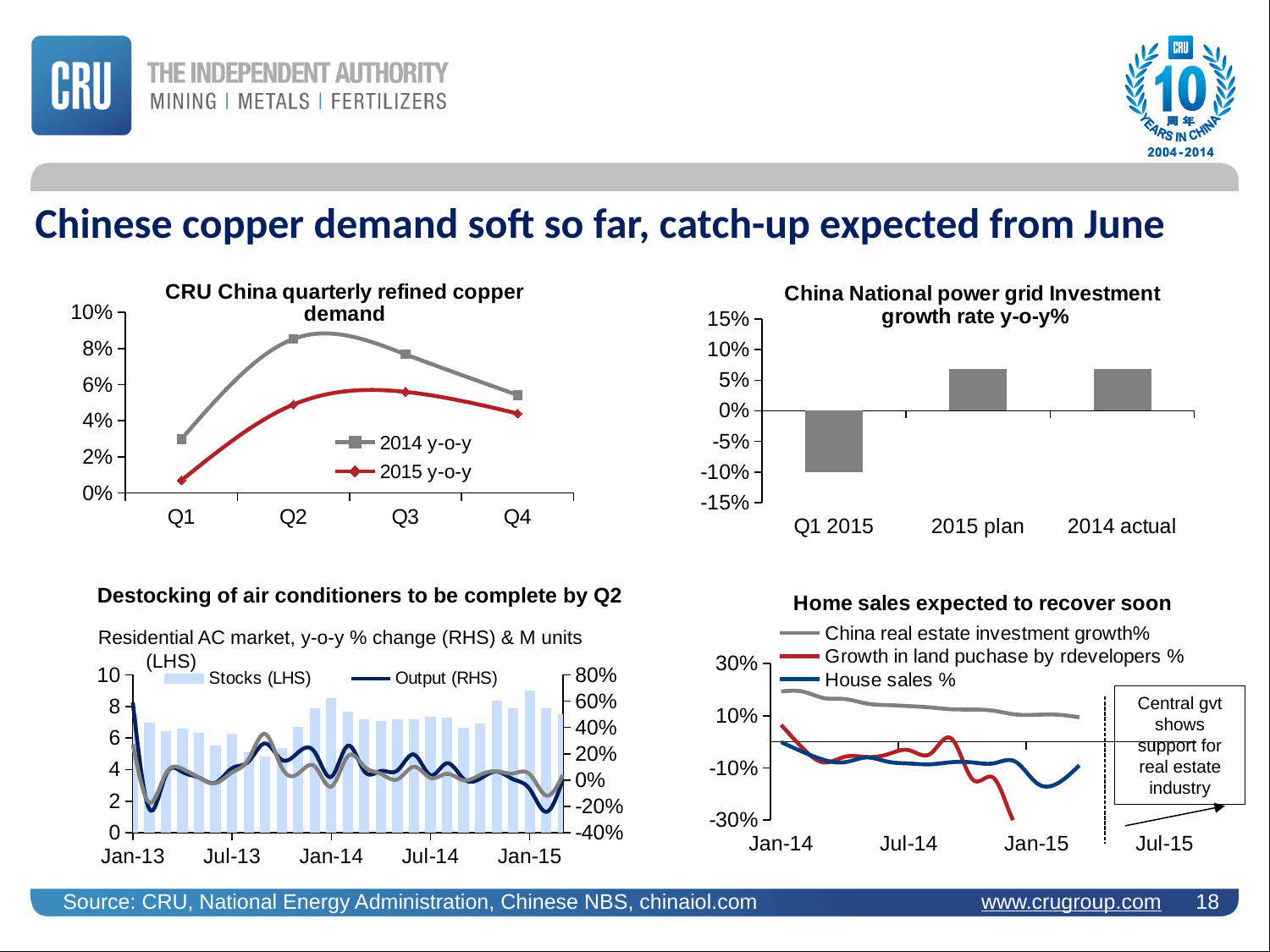
In the 'CRU China quarterly refined copper demand' chart, which is larger in Q1: the 2014 y-o-y value or the 2015 y-o-y value? 2014 y-o-y How many series does the legend of the 'CRU China quarterly refined copper demand' chart list? 2 In the 'CRU China quarterly refined copper demand' chart, which quarter has the lowest value for the 2015 y-o-y series? Q1 In the 'Destocking of air conditioners to be complete by Q2' chart, which series is plotted as bars according to the legend? Stocks (LHS) In the 'CRU China quarterly refined copper demand' chart, is the 2014 y-o-y value for Q1 greater or less than 4%? less How many categories are shown in the 'China National power grid Investment growth rate y-o-y%' chart? 3 In the 'China National power grid Investment growth rate y-o-y%' chart, is the value for Q1 2015 greater or less than -5%? less How many series does the legend of the 'Home sales expected to recover soon' chart list? 3 In the 'China National power grid Investment growth rate y-o-y%' chart, which category has the lowest value? Q1 2015 In the 'CRU China quarterly refined copper demand' chart, which quarter has the highest value for the 2014 y-o-y series? Q2 In the 'CRU China quarterly refined copper demand' chart, is the 2015 y-o-y value for Q1 greater or less than 2%? less What kind of chart is the 'China National power grid Investment growth rate y-o-y%' chart? Bar chart